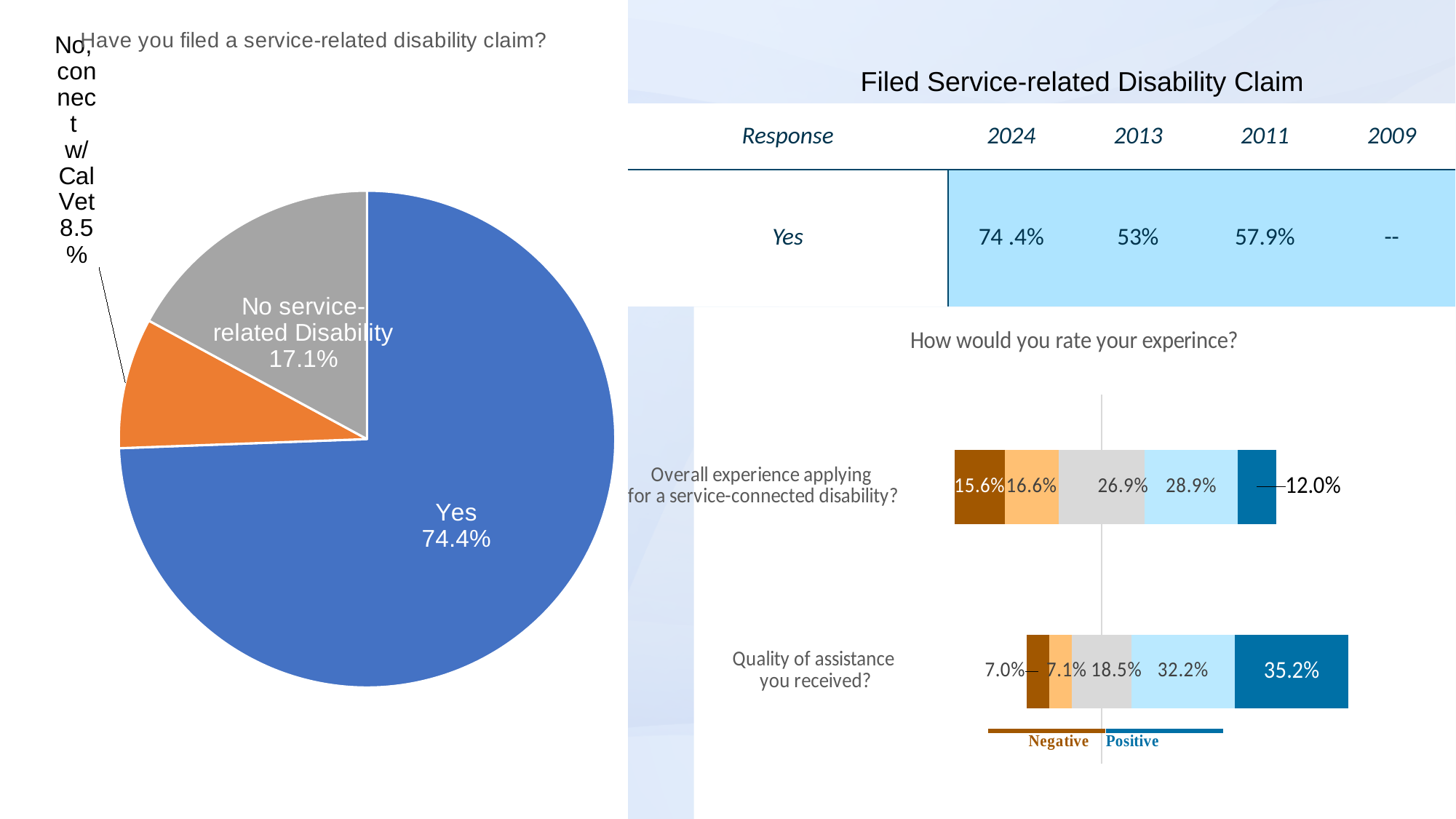
In the pie chart 'Have you filed a service-related disability claim?', what share of respondents answered Yes? 74.4% In the chart 'How would you rate your experince?', how many categories (bars) are shown? 2 In the pie chart 'Have you filed a service-related disability claim?', what share is labelled 'No service-related Disability'? 17.1% What kind of chart is 'How would you rate your experince?'? Stacked bar chart In the pie chart 'Have you filed a service-related disability claim?', how many slices are there? 3 In the chart 'How would you rate your experince?', which category has the larger most-positive (dark blue) segment: 'Overall experience applying for a service-connected disability?' or 'Quality of assistance you received?'? Quality of assistance you received? In the pie chart 'Have you filed a service-related disability claim?', what share is labelled 'No, connect w/ CalVet'? 8.5% In the pie chart 'Have you filed a service-related disability claim?', which slice is the largest? Yes In the pie chart 'Have you filed a service-related disability claim?', how many percentage points larger is the Yes slice than the 'No service-related Disability' slice? 57.3 percentage points In the pie chart 'Have you filed a service-related disability claim?', which slice is the smallest? No, connect w/ CalVet In the chart 'How would you rate your experince?', what is the value of the darkest blue (most positive) segment for 'Quality of assistance you received?'? 35.2% In the chart 'How would you rate your experince?', what is the value of the darkest brown (most negative) segment for 'Overall experience applying for a service-connected disability?'? 15.6%